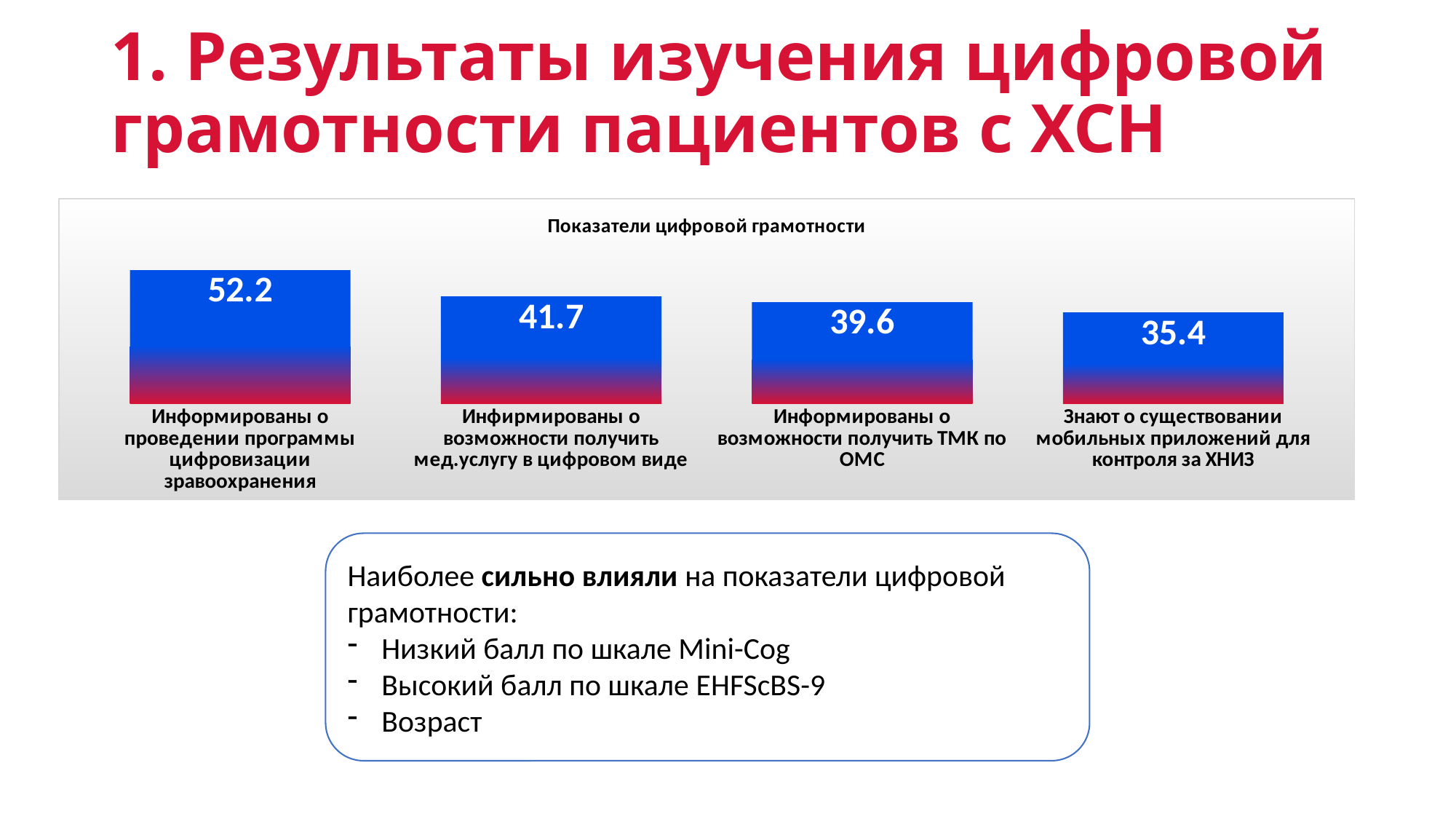
What is the title of the chart? Показатели цифровой грамотности Which category has the highest value? Информированы о проведении программы цифровизации зравоохранения What is the difference between the values for 'Инфирмированы о возможности получить мед.услугу в цифровом виде' and 'Информированы о возможности получить ТМК по ОМС'? 2.1 What is the value for 'Знают о существовании мобильных приложений для контроля за ХНИЗ'? 35.4 What is the value for 'Информированы о проведении программы цифровизации зравоохранения'? 52.2 What is the value for 'Инфирмированы о возможности получить мед.услугу в цифровом виде'? 41.7 What is the value for 'Информированы о возможности получить ТМК по ОМС'? 39.6 Which category has the lowest value? Знают о существовании мобильных приложений для контроля за ХНИЗ What kind of chart is shown on the slide? Bar chart What is the difference between the highest value (52.2) and the lowest value (35.4)? 16.8 How many categories are shown in the chart? 4 Which is larger: the value for 'Информированы о возможности получить ТМК по ОМС' or the value for 'Знают о существовании мобильных приложений для контроля за ХНИЗ'? Информированы о возможности получить ТМК по ОМС